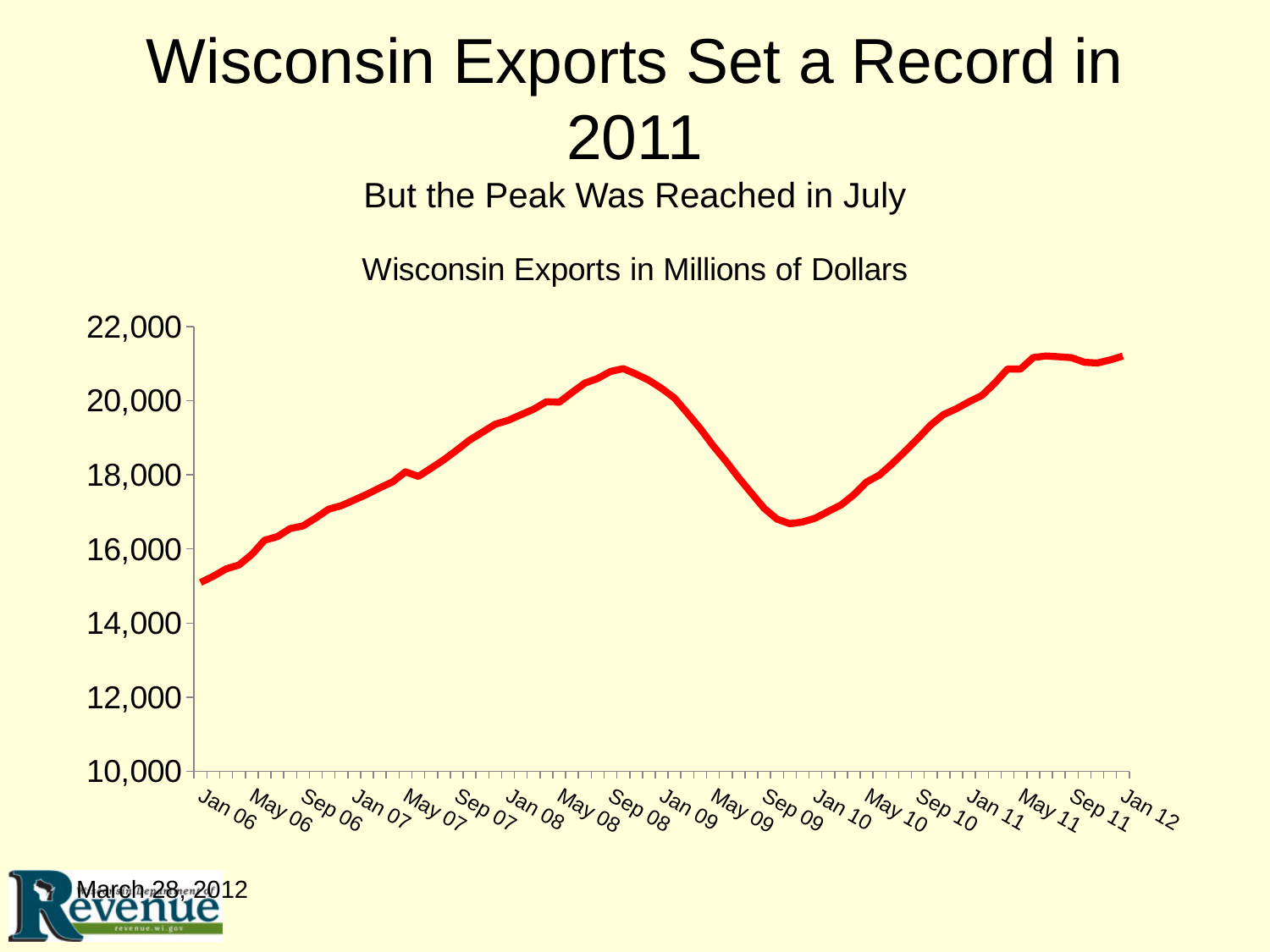
What kind of chart is shown on the slide? line chart Is the value for Sep 09 greater or less than 18,000? less Is the value for Jan 12 greater or less than 20,000? greater Do exports rise or fall between Sep 08 and Sep 09? fall Is the value for Jan 06 greater or less than 16,000? less Which is larger, the value for Sep 08 or the value for Sep 09? Sep 08 Which of the labeled months has the lowest export value, Jan 06 or Sep 09? Jan 06 How many lines (series) are plotted on the chart? 1 What colour is the line plotted on the chart? red What is the title of the chart? Wisconsin Exports in Millions of Dollars